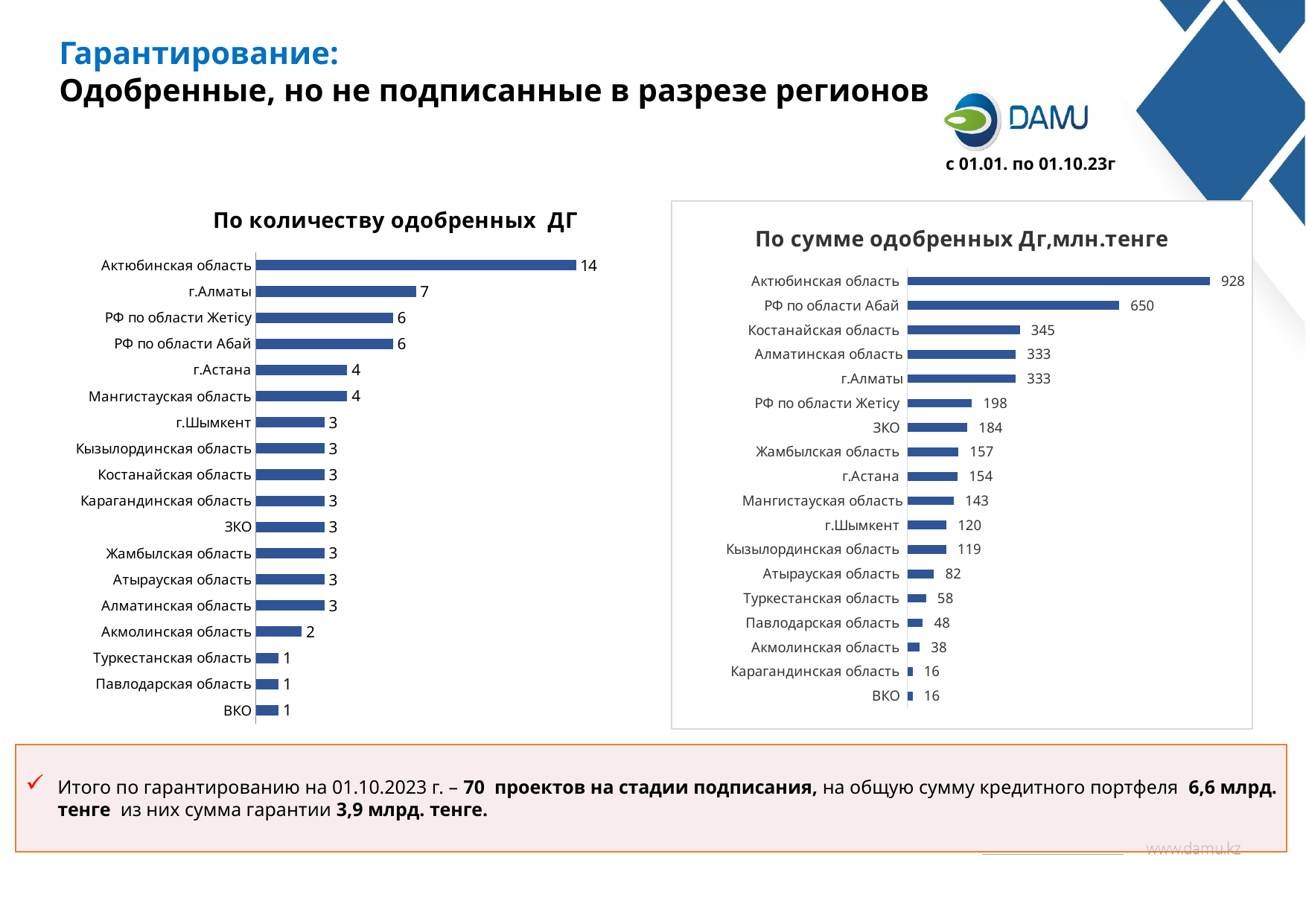
In the chart 'По количеству одобренных ДГ', how many regions are shown? 18 In the chart 'По сумме одобренных Дг,млн.тенге', what is the value for Павлодарская область? 48 In the chart 'По количеству одобренных ДГ', what is the value for Актюбинская область? 14 In the chart 'По сумме одобренных Дг,млн.тенге', what is the difference between Актюбинская область and Костанайская область? 583 In the chart 'По количеству одобренных ДГ', which region has the highest value? Актюбинская область In the chart 'По сумме одобренных Дг,млн.тенге', which region has the highest value? Актюбинская область In the chart 'По сумме одобренных Дг,млн.тенге', which is larger: ЗКО or Жамбылская область? ЗКО In the chart 'По количеству одобренных ДГ', what is the difference between г.Алматы and Акмолинская область? 5 In the chart 'По количеству одобренных ДГ', what is the value for г.Астана? 4 What type of chart is 'По сумме одобренных Дг,млн.тенге'? Bar chart In the chart 'По сумме одобренных Дг,млн.тенге', what is the value for Мангистауская область? 143 In the chart 'По сумме одобренных Дг,млн.тенге', what is the value for РФ по области Абай? 650